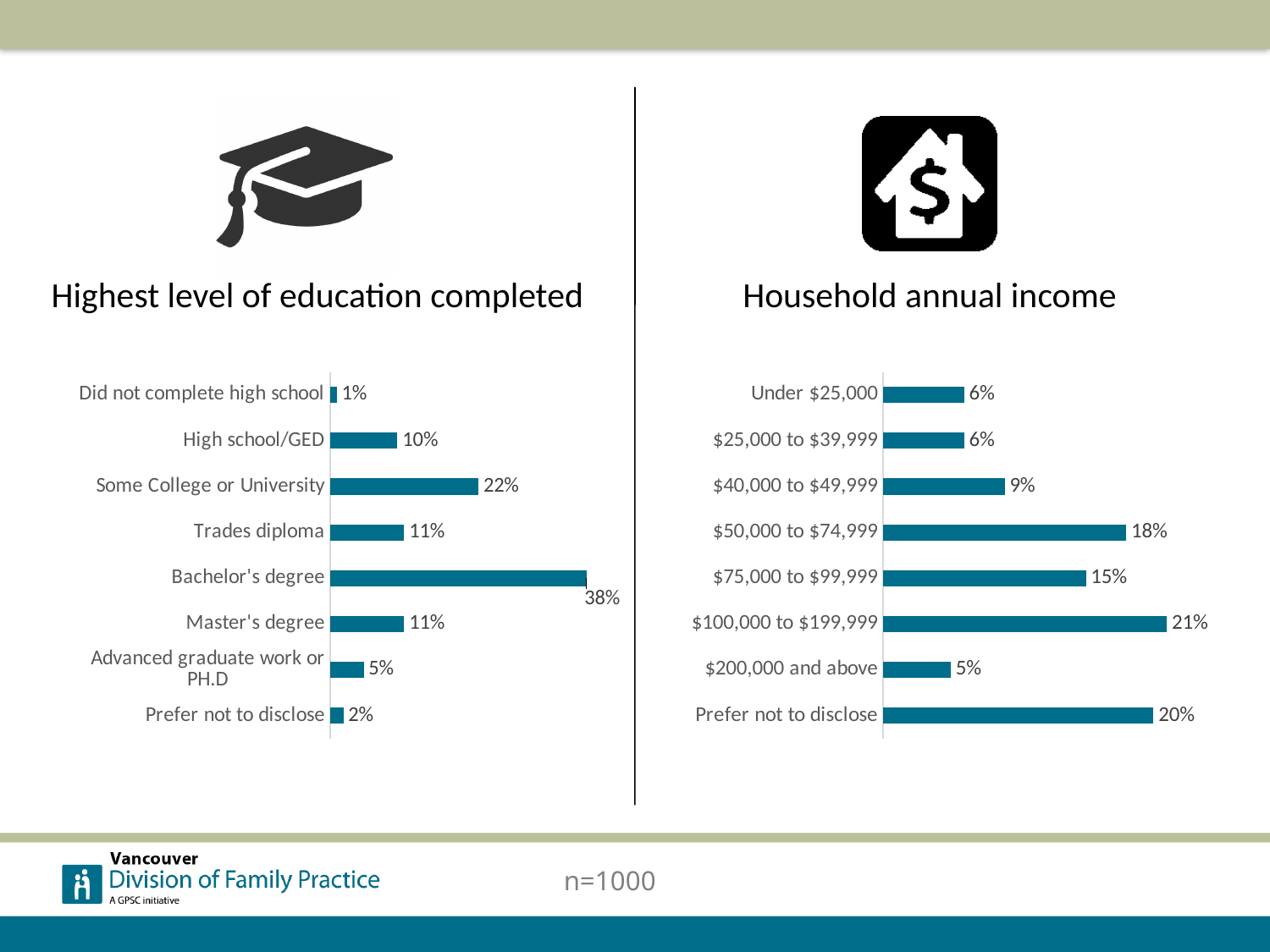
In the 'Highest level of education completed' chart, what percentage of respondents have a Bachelor's degree? 38% In the 'Highest level of education completed' chart, which category has the lowest value? Did not complete high school In the 'Highest level of education completed' chart, how many categories are shown? 8 What type of chart is used for 'Household annual income'? Bar chart In the 'Household annual income' chart, what is the difference between Prefer not to disclose and $200,000 and above? 15% In the 'Household annual income' chart, how many income categories are shown? 8 In the 'Household annual income' chart, what percentage of respondents earn $50,000 to $74,999? 18% In the 'Household annual income' chart, which is larger: $75,000 to $99,999 or $40,000 to $49,999? $75,000 to $99,999 What sample size is shown at the bottom of the slide? n=1000 In the 'Highest level of education completed' chart, what is the difference between Some College or University and High school/GED? 12% In the 'Household annual income' chart, which income category has the highest value? $100,000 to $199,999 In the 'Highest level of education completed' chart, what is the value for Advanced graduate work or PH.D? 5%